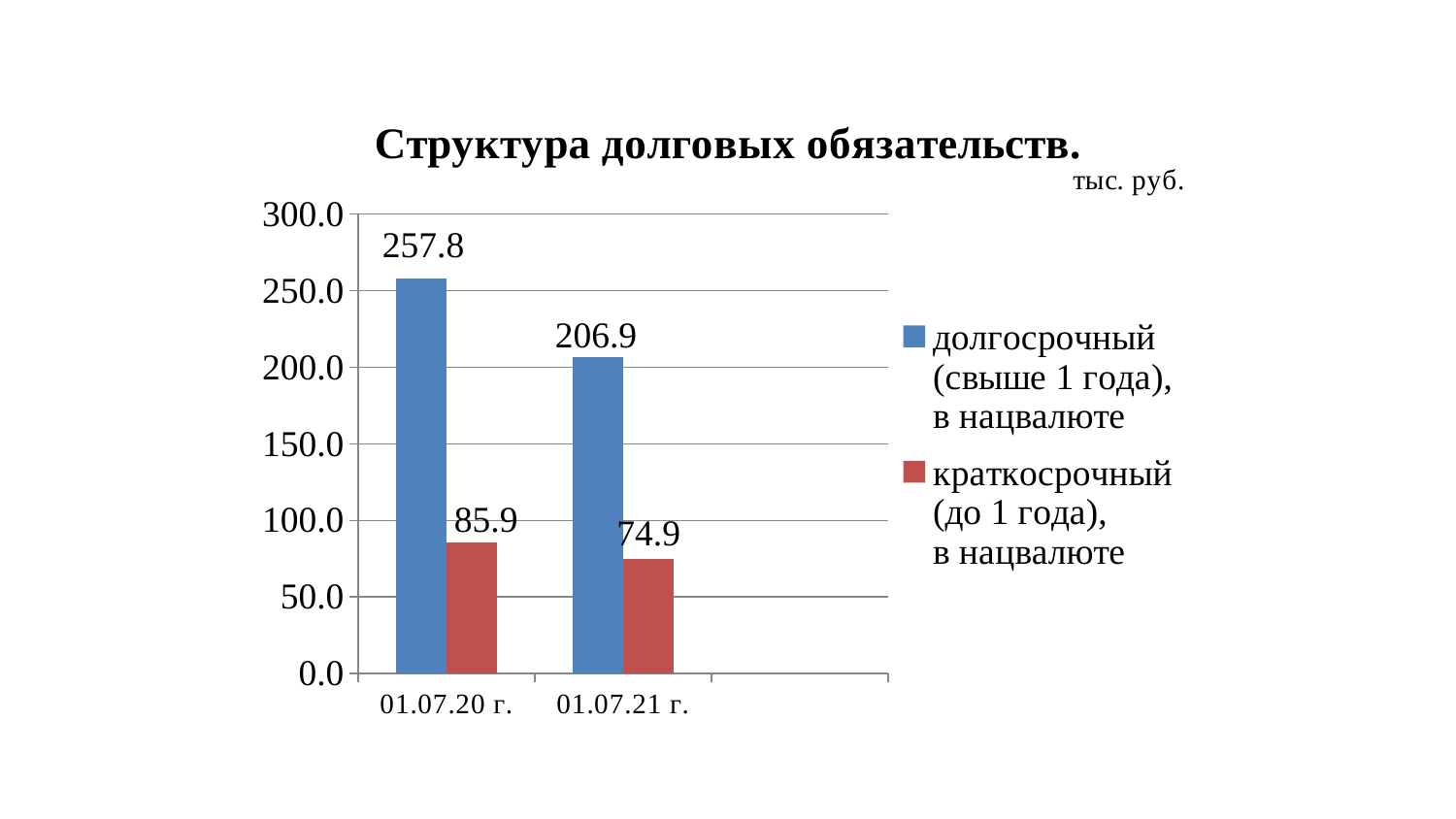
What kind of chart is shown on the slide? bar chart What is the value for краткосрочный (до 1 года), в нацвалюте on 01.07.21 г.? 74.9 What is the value for долгосрочный (свыше 1 года), в нацвалюте on 01.07.20 г.? 257.8 How many series does the legend list? 2 What is the difference between the долгосрочный values on 01.07.20 г. and 01.07.21 г.? 50.9 How many dates are shown on the x axis? 2 Which is larger on 01.07.21 г.: долгосрочный or краткосрочный? долгосрочный What is the value for краткосрочный (до 1 года), в нацвалюте on 01.07.20 г.? 85.9 What is the value for долгосрочный (свыше 1 года), в нацвалюте on 01.07.21 г.? 206.9 Which date has the highest value for долгосрочный (свыше 1 года), в нацвалюте? 01.07.20 г. Is the value for краткосрочный on 01.07.20 г. greater or less than 100.0? less Which date has the lowest value for краткосрочный (до 1 года), в нацвалюте? 01.07.21 г.